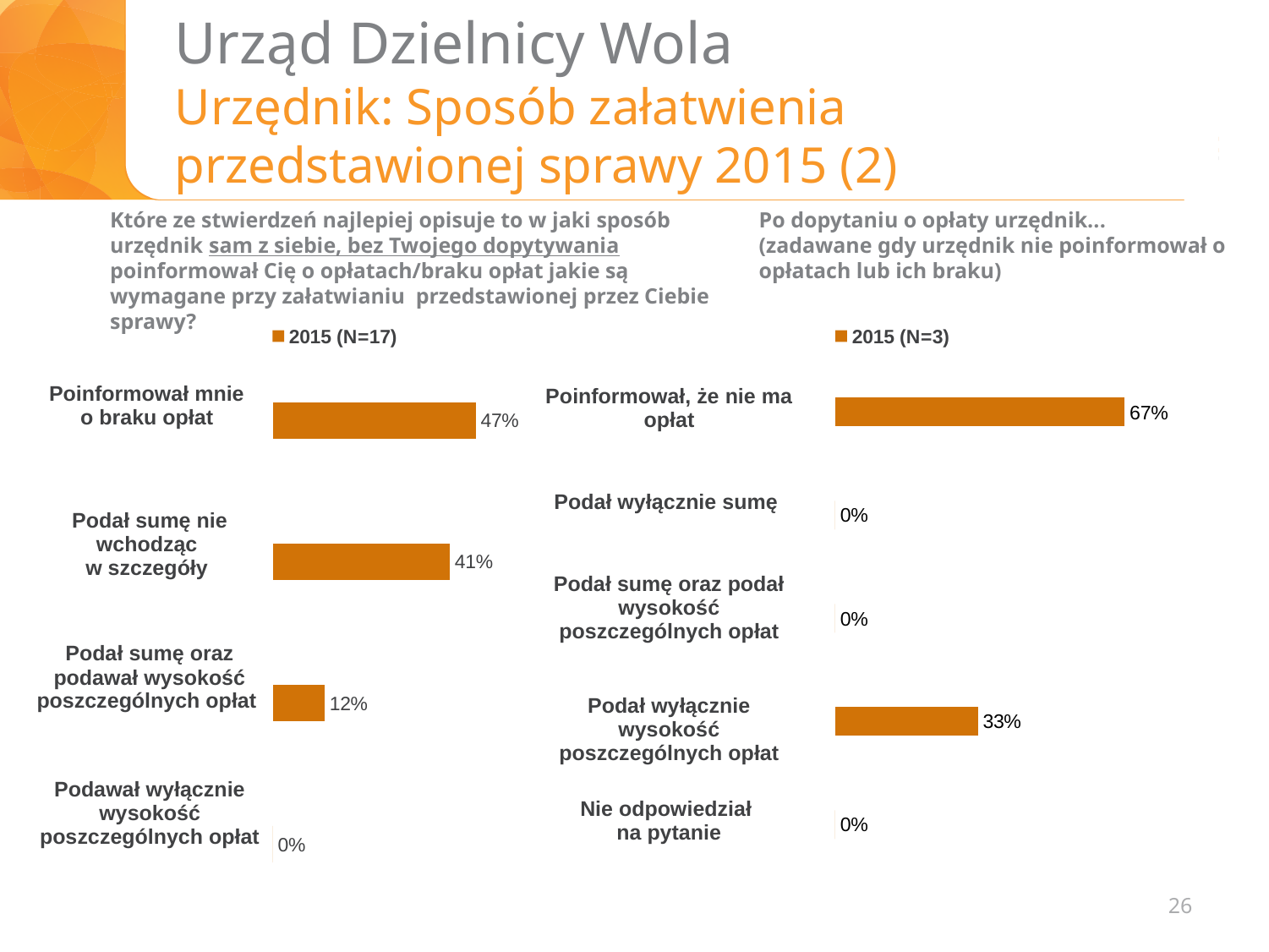
In the right chart (2015, N=3), what is the difference between "Poinformował, że nie ma opłat" and "Podał wyłącznie wysokość poszczególnych opłat"? 34% In the left chart (2015, N=17), which category has the highest value? Poinformował mnie o braku opłat In the left chart (2015, N=17), how many categories are shown? 4 In the right chart (2015, N=3), how many categories are shown? 5 In the left chart (2015, N=17), what is the value for "Poinformował mnie o braku opłat"? 47% In the right chart (2015, N=3), what is the value for "Nie odpowiedział na pytanie"? 0% In the right chart (2015, N=3), what is the value for "Poinformował, że nie ma opłat"? 67% What type of chart is the left chart (2015, N=17)? Bar chart In the right chart (2015, N=3), what is the value for "Podał wyłącznie wysokość poszczególnych opłat"? 33% In the left chart (2015, N=17), what is the value for "Podał sumę nie wchodząc w szczegóły"? 41% In the left chart (2015, N=17), what is the value for "Podał sumę oraz podawał wysokość poszczególnych opłat"? 12% In the left chart (2015, N=17), what is the difference between "Poinformował mnie o braku opłat" and "Podał sumę nie wchodząc w szczegóły"? 6%